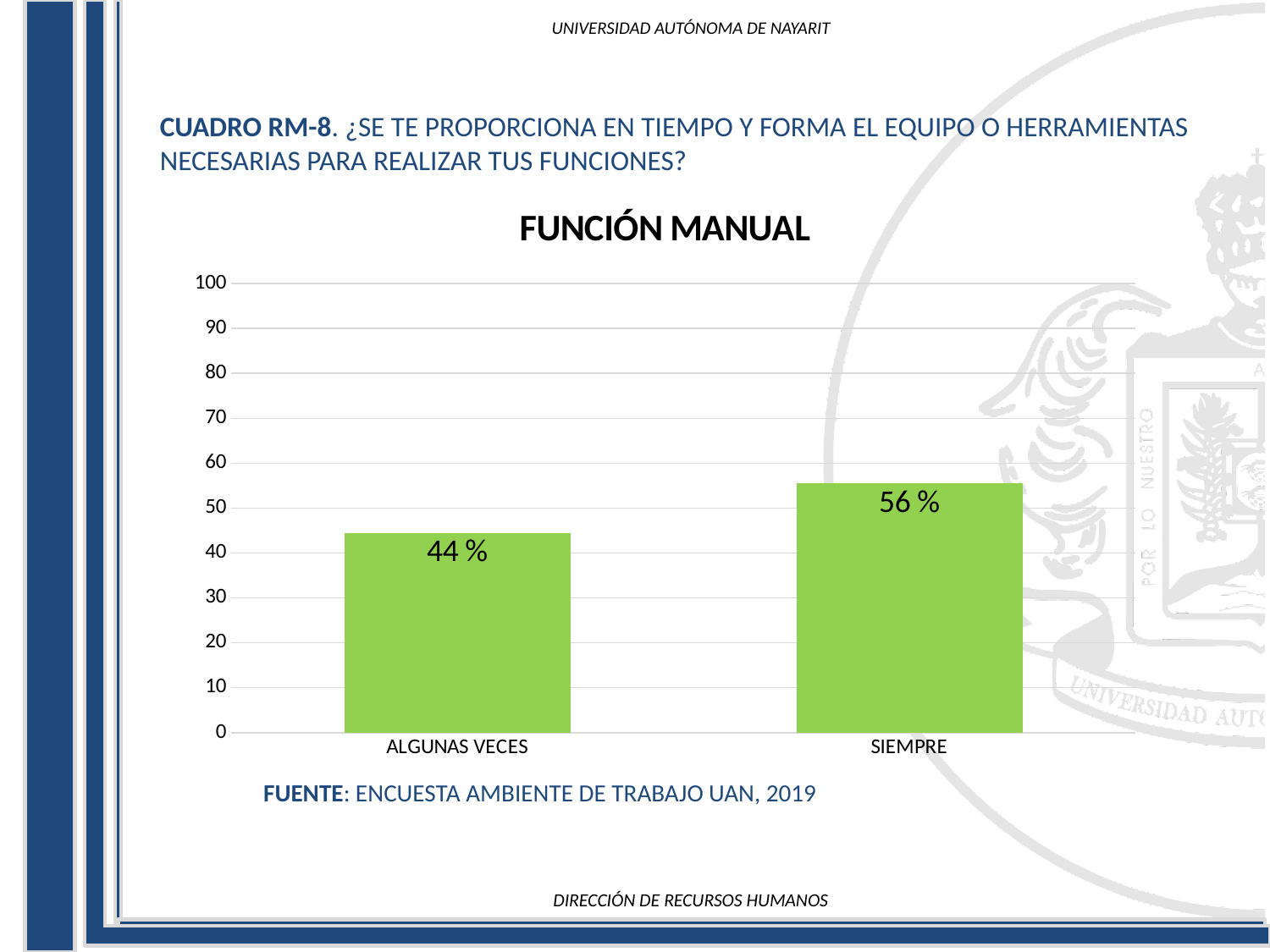
Is the value for ALGUNAS VECES greater or less than 50? less What kind of chart is shown on the slide? bar chart Which category has the highest value? SIEMPRE Is the value for SIEMPRE greater or less than 50? greater What colour are the bars in the chart? green How many categories are shown on the x axis? 2 What is the value for SIEMPRE? 56 % Which category has the lowest value? ALGUNAS VECES What is the title of the chart? FUNCIÓN MANUAL What is the value for ALGUNAS VECES? 44 % What is the difference between the values for SIEMPRE and ALGUNAS VECES? 12 % Which is larger, the value for ALGUNAS VECES or the value for SIEMPRE? SIEMPRE